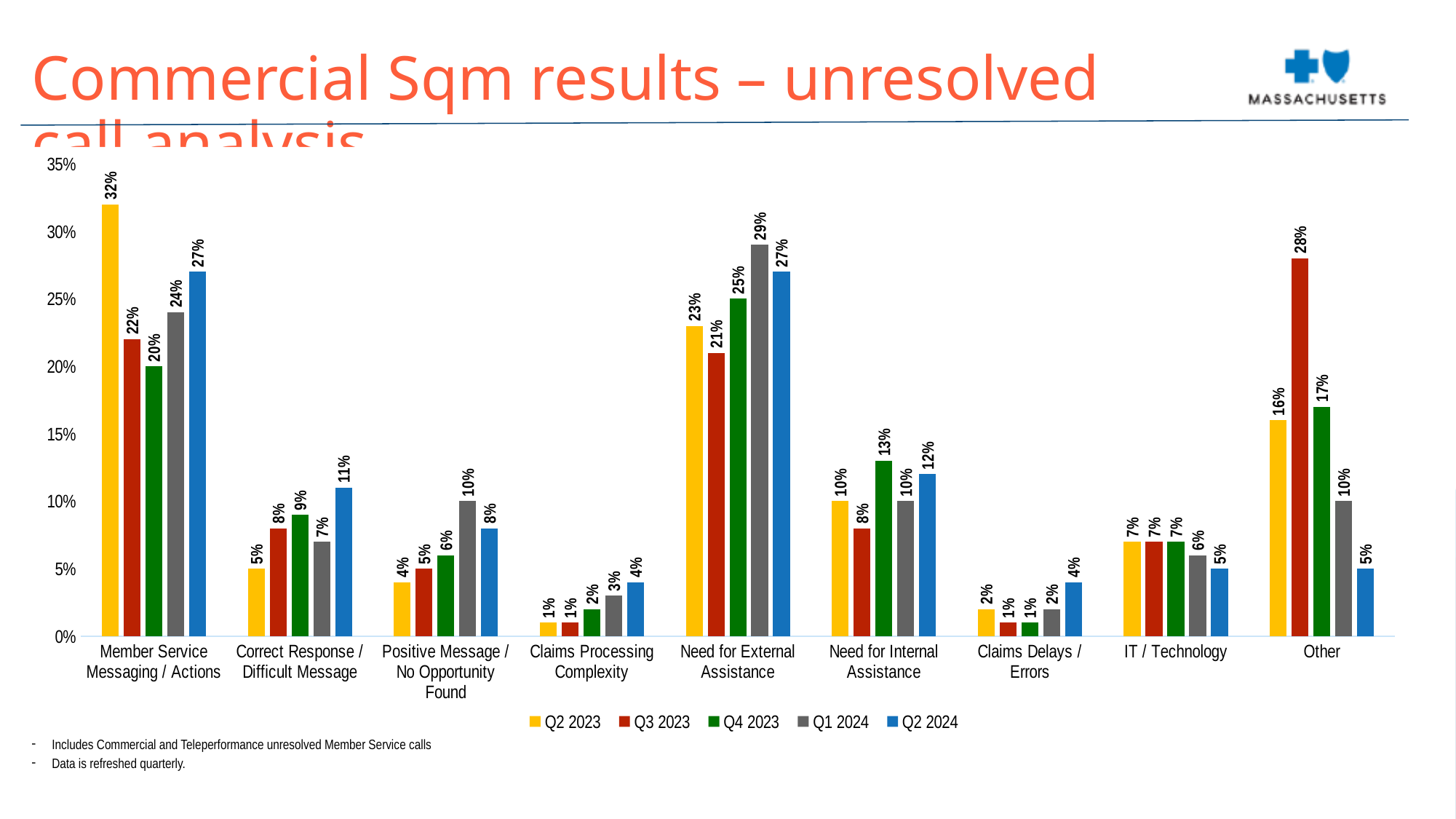
How many series does the legend list? 5 What is the Q1 2024 value for Need for External Assistance? 29% Which series is shown in blue in the legend? Q2 2024 How many categories are shown on the x axis? 9 Do the values for Claims Processing Complexity rise or fall from Q2 2023 to Q2 2024? Rise Which category has the highest Q2 2023 value? Member Service Messaging / Actions What is the Q3 2023 value for Other? 28% What is the Q2 2024 value for Member Service Messaging / Actions? 27% What kind of chart is shown on the slide? Bar chart Which is larger for Need for Internal Assistance: the Q4 2023 value or the Q2 2024 value? Q4 2023 What is the difference between the Q2 2023 and Q2 2024 values for Member Service Messaging / Actions? 5%